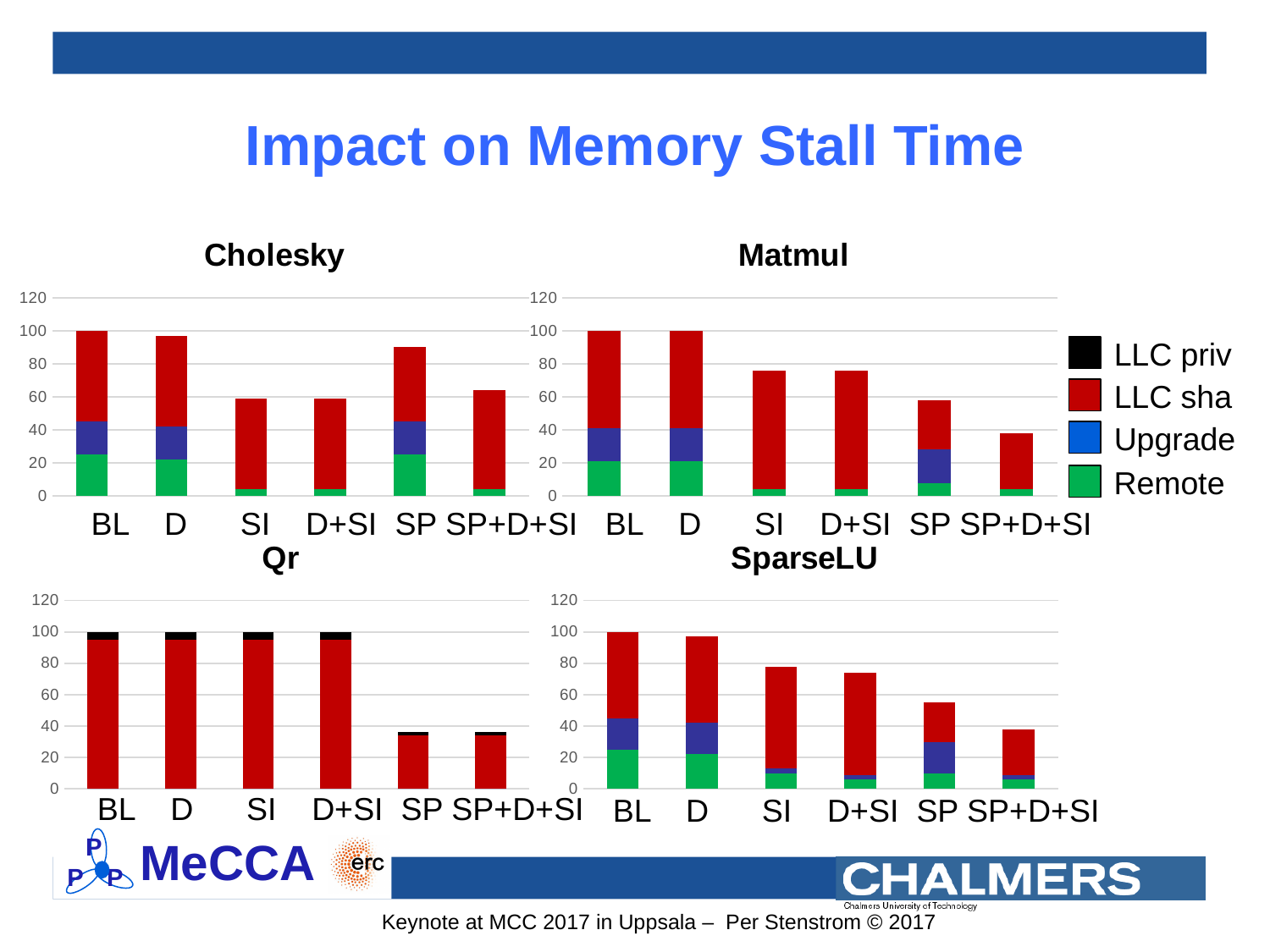
In the Matmul chart, which has the larger total bar, SI or SP? SI In the SparseLU chart, which category has the lowest total bar? SP+D+SI In the legend, which colour represents LLC sha? Red In the Qr chart, which has the larger total bar, BL or SP? BL How many series does the legend list? 4 In the Matmul chart, which category has the lowest total bar? SP+D+SI How many categories are shown on the x axis of the Matmul chart? 6 In the SparseLU chart, is the total for SI greater or less than 60? greater In the Qr chart, is the total for SP greater or less than 60? less Which series are listed in the legend? LLC priv, LLC sha, Upgrade, Remote In the Cholesky chart, is the total for SI greater or less than 40? greater What kind of chart is the Cholesky chart? Stacked bar chart